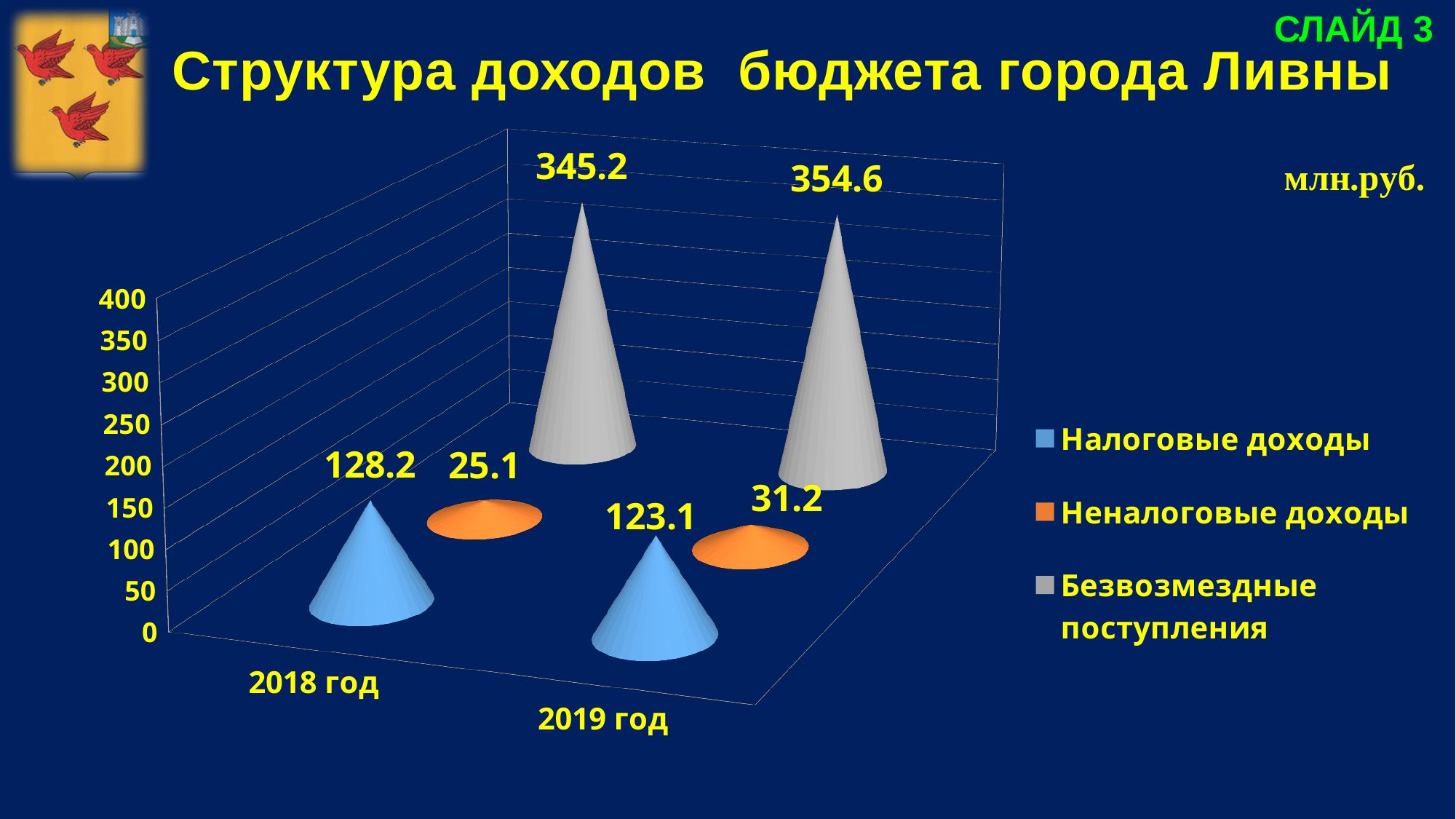
Which series has the highest value in 2018 год? Безвозмездные поступления How many series does the legend list? 3 Which is larger: Неналоговые доходы in 2018 год or in 2019 год? 2019 год What unit of measurement is indicated on the slide for the chart values? млн.руб. Do Налоговые доходы rise or fall from 2018 год to 2019 год? fall What is the value of Безвозмездные поступления for 2019 год? 354.6 By how much did Безвозмездные поступления change from 2018 год to 2019 год? 9.4 What is the difference between Налоговые доходы in 2018 год and 2019 год? 5.1 What is the value of Неналоговые доходы for 2019 год? 31.2 How many year categories are shown on the x axis? 2 What is the value of Налоговые доходы for 2018 год? 128.2 Which series has the lowest value in 2019 год? Неналоговые доходы